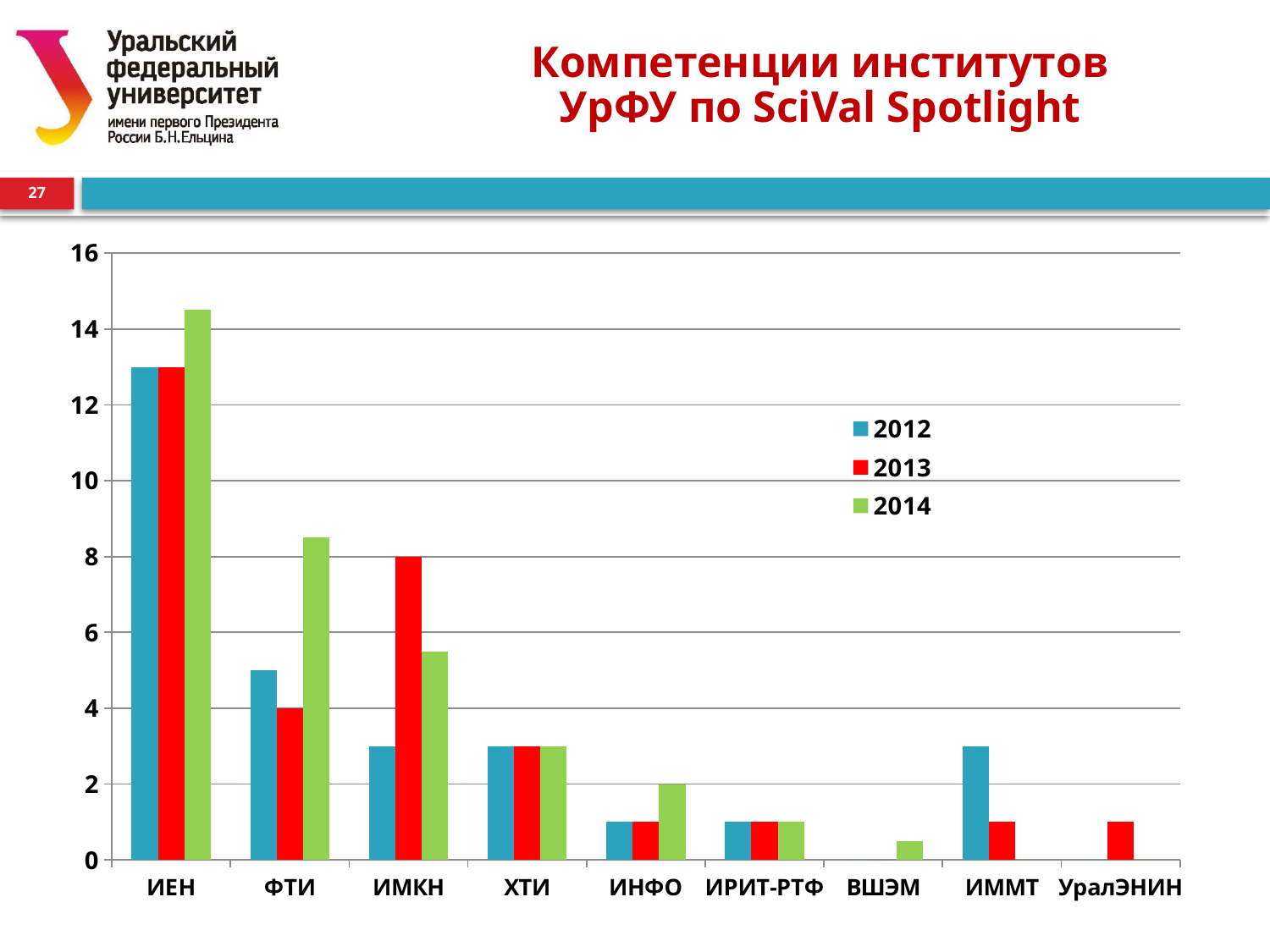
How many series does the legend list? 3 What kind of chart is shown on the slide? bar chart Is the 2012 value for ИММТ greater or less than 2? greater What is the 2013 value for ФТИ? 4 What is the 2014 value for ИНФО? 2 Which colour represents the 2013 series in the legend? red Is the 2014 value for ФТИ greater or less than 8? greater What is the 2013 value for ИМКН? 8 How many institutes (categories) are shown on the x axis? 9 For ИМКН, which is larger: the 2013 value or the 2014 value? 2013 Is the 2014 value for ИЕН greater or less than 14? greater Which institute has the highest 2014 value? ИЕН